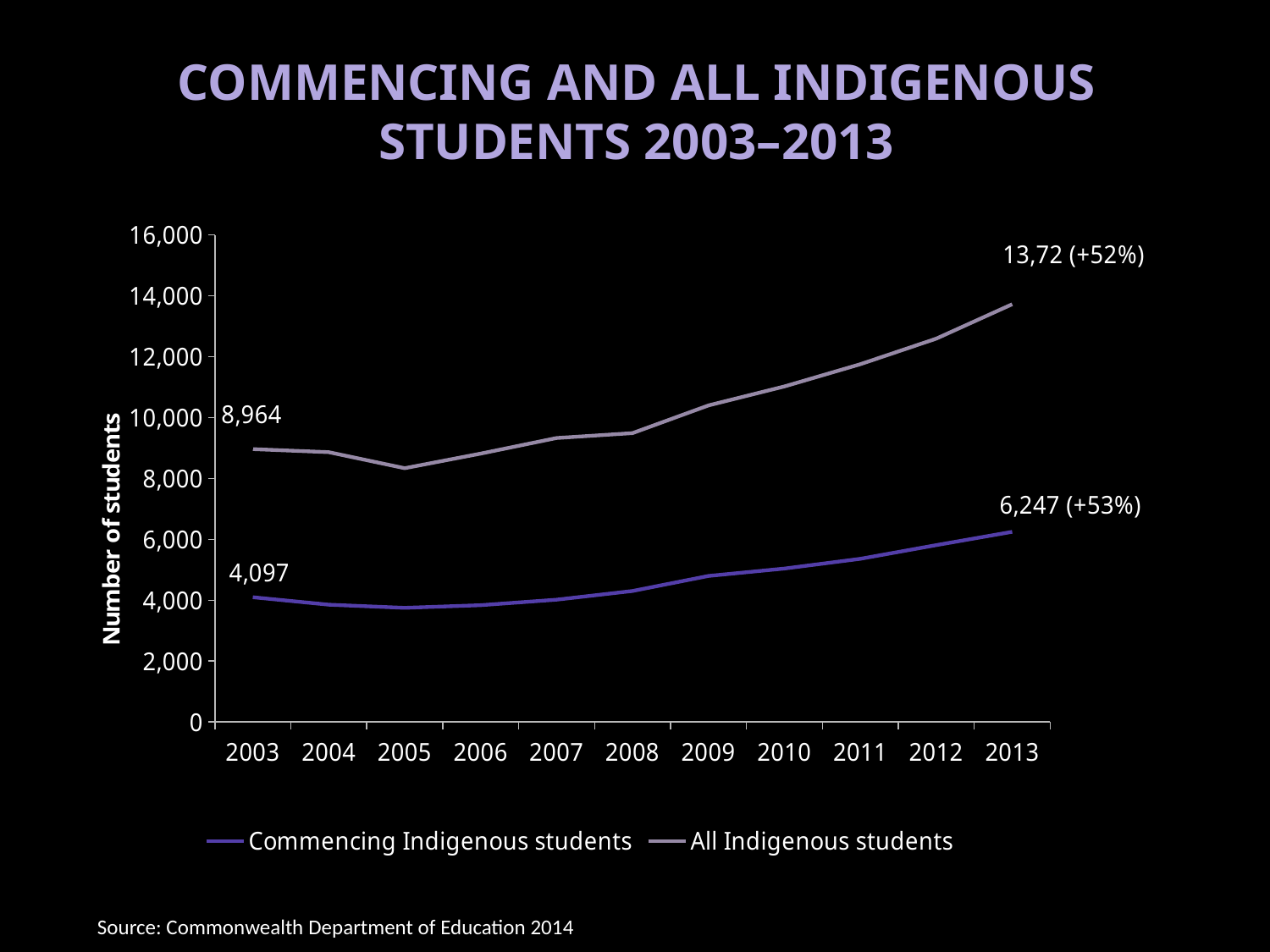
What was the number of All Indigenous students in 2003? 8,964 Overall, do the values for All Indigenous students rise or fall from 2003 to 2013? rise What type of chart is shown on the slide? line chart What was the number of Commencing Indigenous students in 2013? 6,247 Is the value for All Indigenous students in 2011 greater or less than 10,000? greater How many series does the legend list? 2 What is the difference between All Indigenous students and Commencing Indigenous students in 2003? 4,867 By what percentage did the number of All Indigenous students increase from 2003 to 2013, according to the data label? +52% In which year was the number of Commencing Indigenous students highest? 2013 What was the number of Commencing Indigenous students in 2003? 4,097 In which year was the number of All Indigenous students lowest? 2005 How many years are shown on the x axis? 11